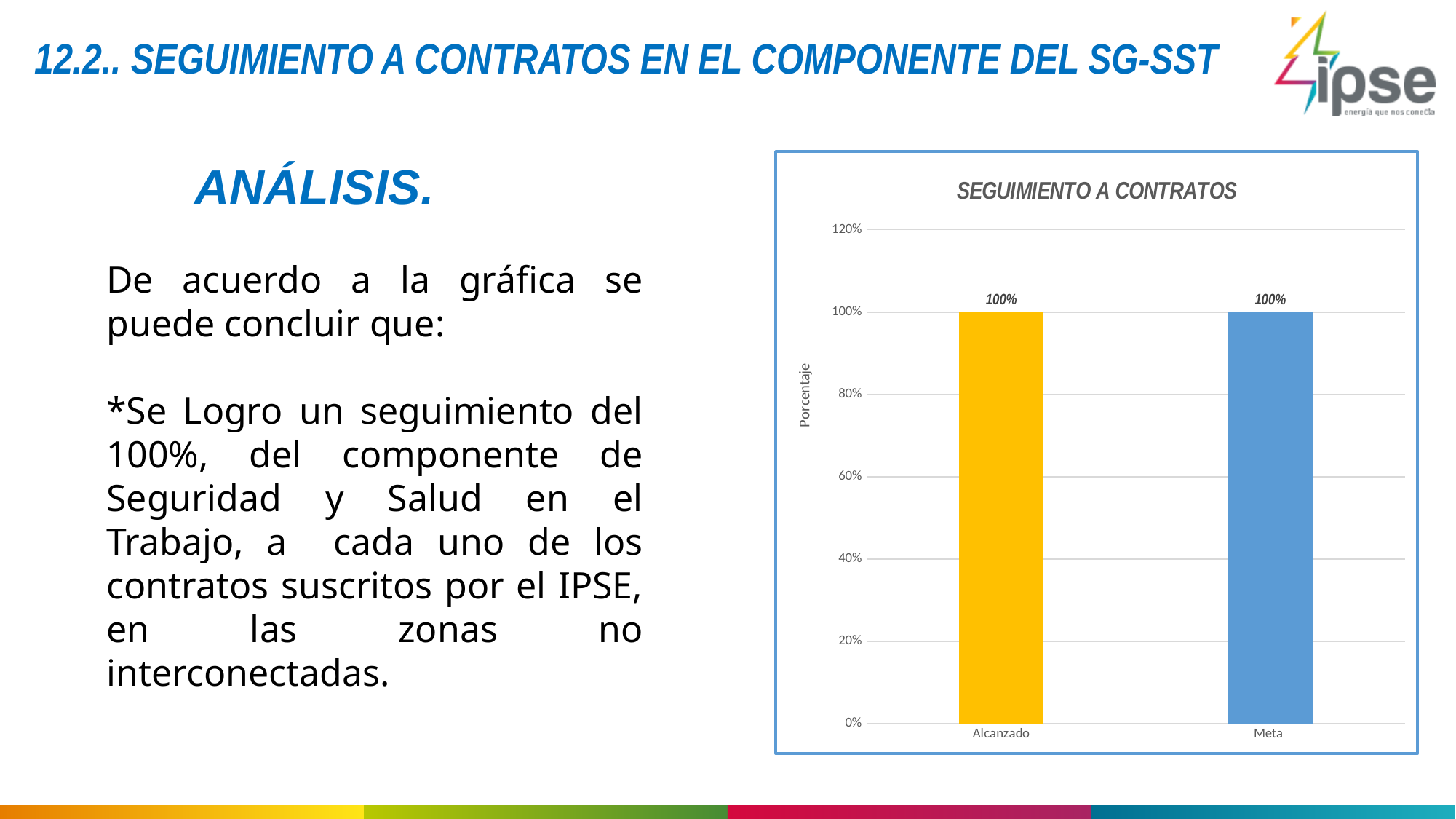
How many categories are shown on the x axis? 2 What is the value for Meta? 100% What is the label of the vertical axis? Porcentaje What is the difference between the values for Alcanzado and Meta? 0% What kind of chart is shown on the slide? Bar chart What is the highest value shown on the vertical axis? 120% Is the value for Meta greater or less than 120%? less What is the value for Alcanzado? 100% Is the value for Alcanzado greater or less than 80%? greater What is the title of the chart? SEGUIMIENTO A CONTRATOS